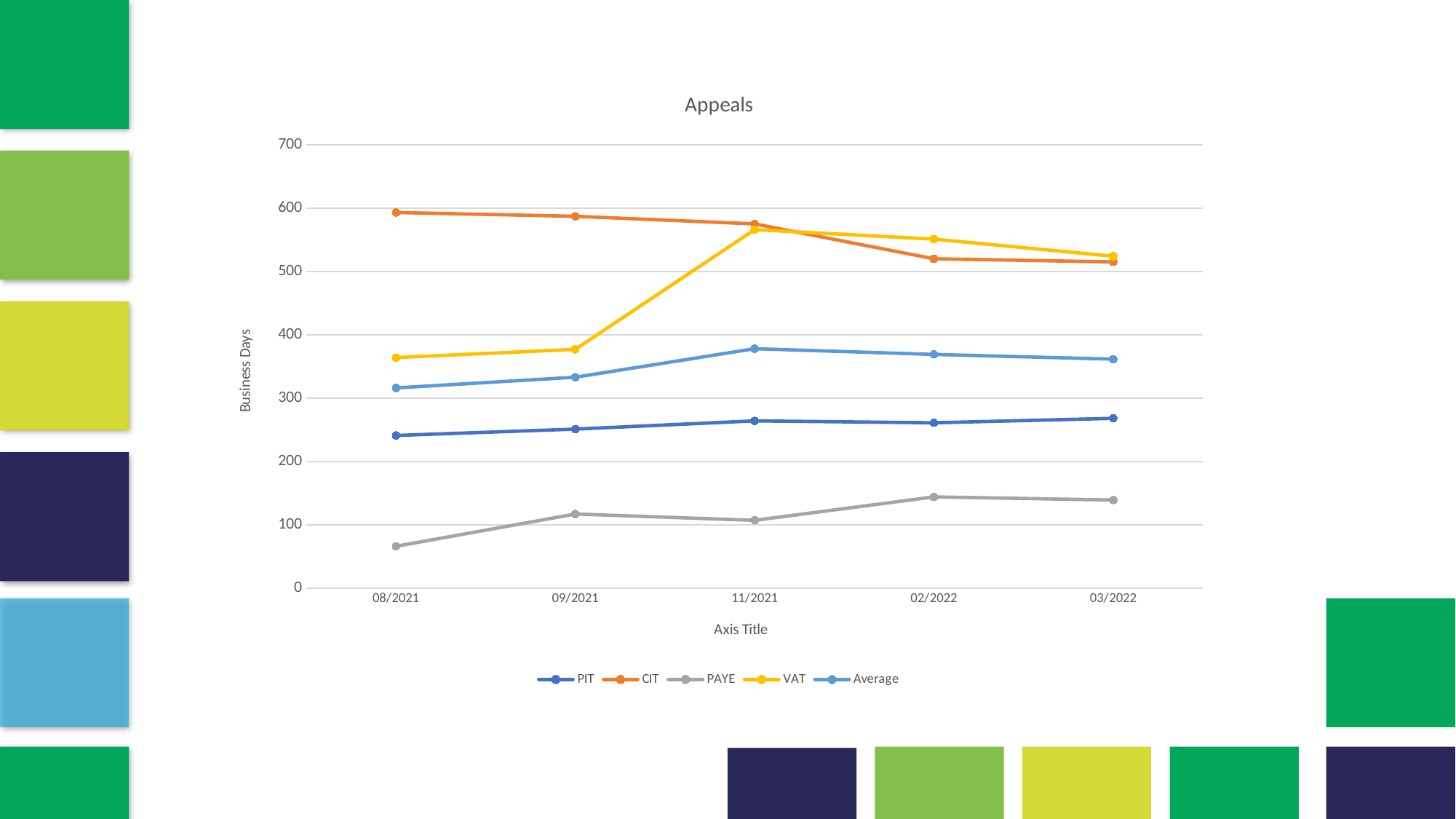
Does the CIT line rise or fall from 08/2021 to 03/2022? fall Which series has the highest value at 08/2021? CIT Which series has the lowest value at 03/2022? PAYE What is the label on the vertical axis of the chart? Business Days Is the value for VAT at 09/2021 greater or less than 400? less What is the title of the chart? Appeals Is the value for PAYE at 08/2021 greater or less than 100? less What kind of chart is shown on the slide? line chart How many time points are plotted along the x axis of the Appeals chart? 5 Is the value for Average at 11/2021 greater or less than 400? less How many series does the legend of the Appeals chart list? 5